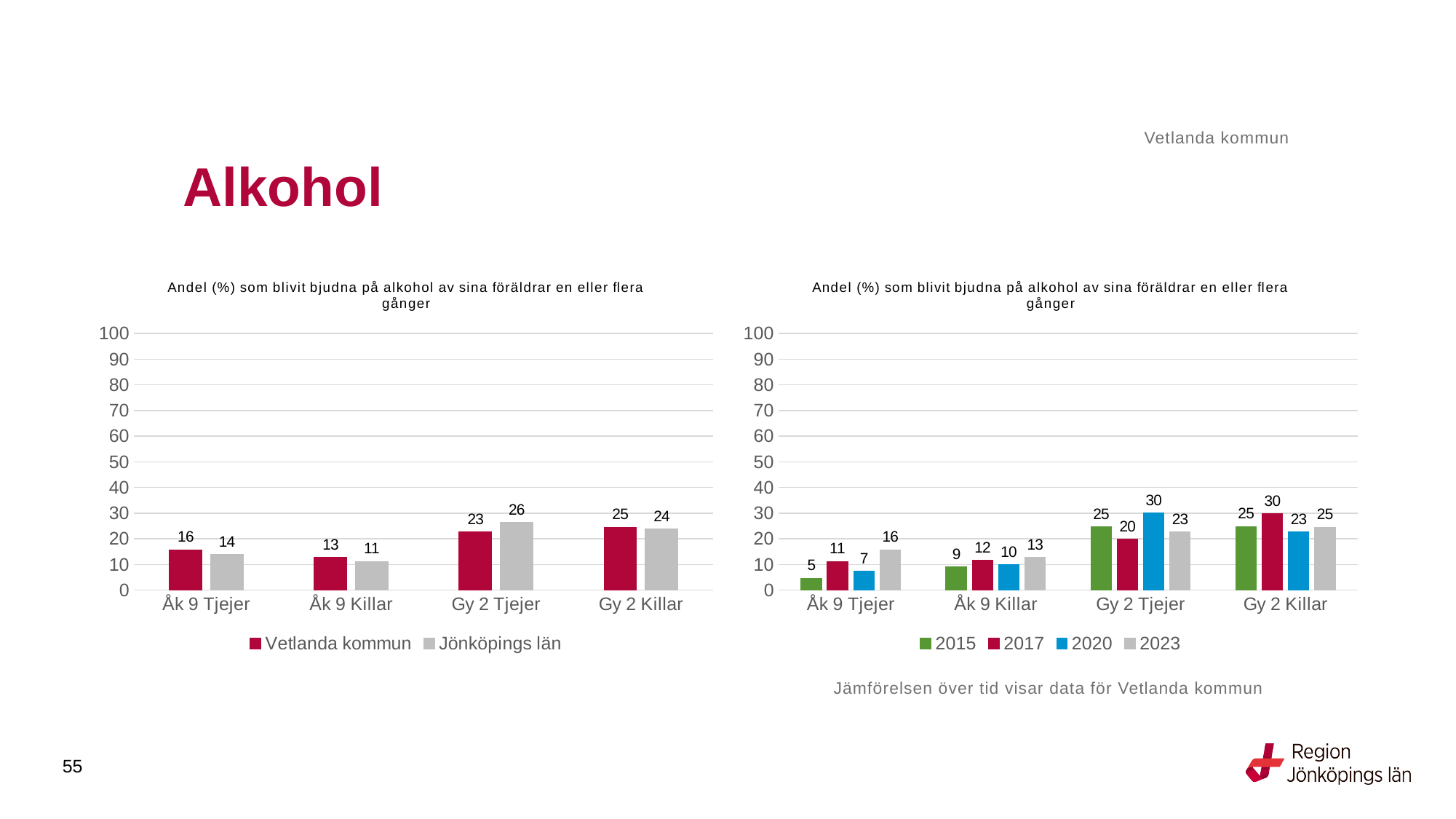
In the right chart, which category has the lowest value for 2017? Åk 9 Tjejer In the right chart, what is the difference between 2023 and 2015 for Åk 9 Tjejer? 11 In the right chart, which is larger for Gy 2 Killar: 2017 or 2020? 2017 In the left chart, what is the difference between Jönköpings län and Vetlanda kommun for Gy 2 Tjejer? 3 In the left chart, what is the value for Jönköpings län for Åk 9 Killar? 11 In the right chart, how many series does the legend list? 4 In the left chart, what is the value for Vetlanda kommun for Gy 2 Tjejer? 23 In the right chart, what is the value for 2015 for Åk 9 Tjejer? 5 In the right chart, what is the value for 2020 for Gy 2 Tjejer? 30 In the left chart, which category has the highest value for Vetlanda kommun? Gy 2 Killar What kind of chart is the right chart? Bar chart In the left chart, how many series does the legend list? 2